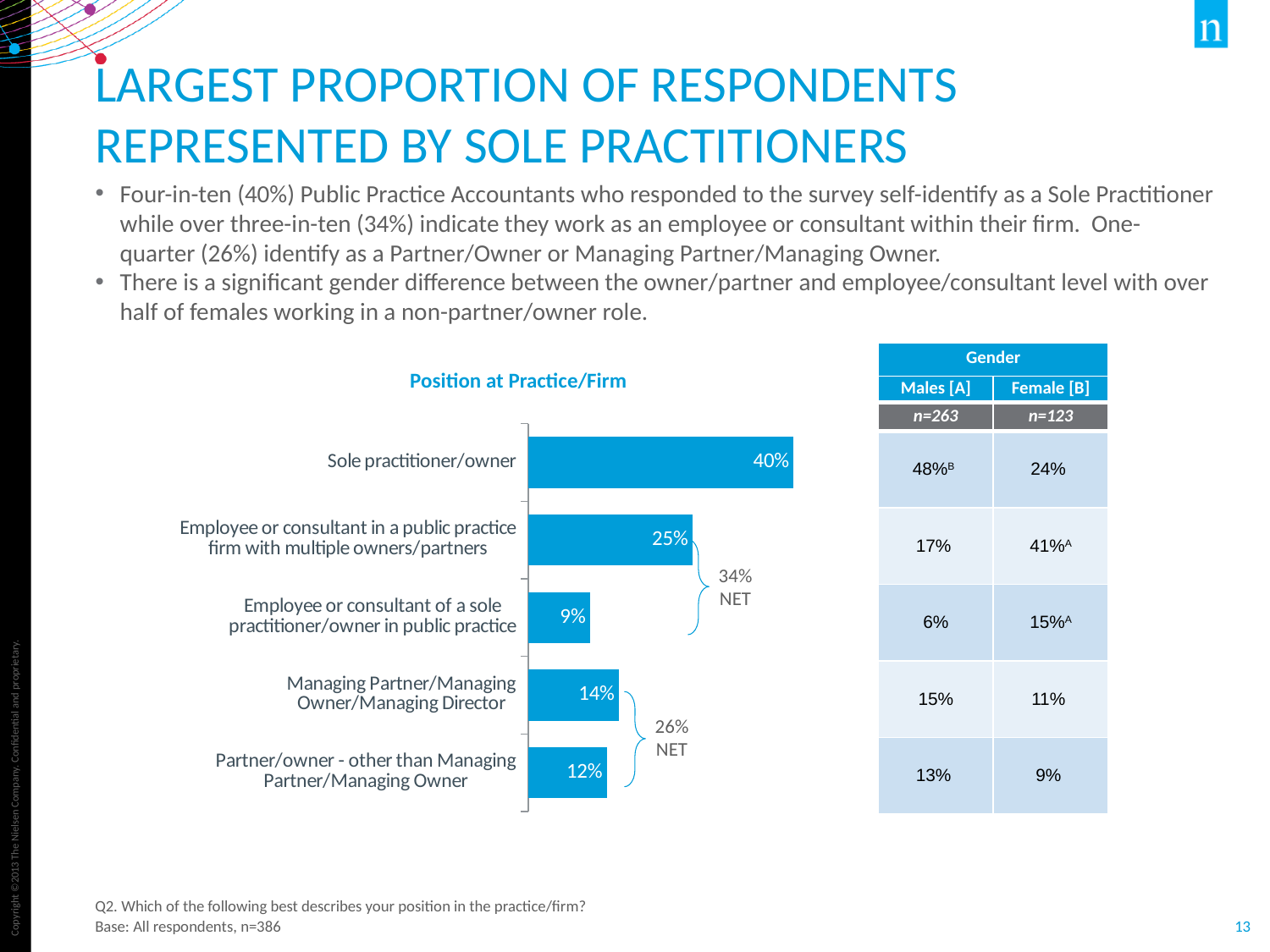
What is the value for Managing Partner/Managing Owner/Managing Director? 14% Which category has the lowest value in the Position at Practice/Firm chart? Employee or consultant of a sole practitioner/owner in public practice What is the value for Employee or consultant of a sole practitioner/owner in public practice? 9% What is the value for Employee or consultant in a public practice firm with multiple owners/partners? 25% Which is larger: the value for Managing Partner/Managing Owner/Managing Director or the value for Partner/owner - other than Managing Partner/Managing Owner? Managing Partner/Managing Owner/Managing Director How many categories are shown in the Position at Practice/Firm chart? 5 What NET value is shown for the two employee/consultant categories combined in the chart? 34% NET What is the value for Sole practitioner/owner in the Position at Practice/Firm chart? 40% Which category has the highest value in the Position at Practice/Firm chart? Sole practitioner/owner What kind of chart is the Position at Practice/Firm chart? Bar chart What is the value for Partner/owner - other than Managing Partner/Managing Owner? 12% What is the difference between the value for Sole practitioner/owner and the value for Employee or consultant in a public practice firm with multiple owners/partners? 15%